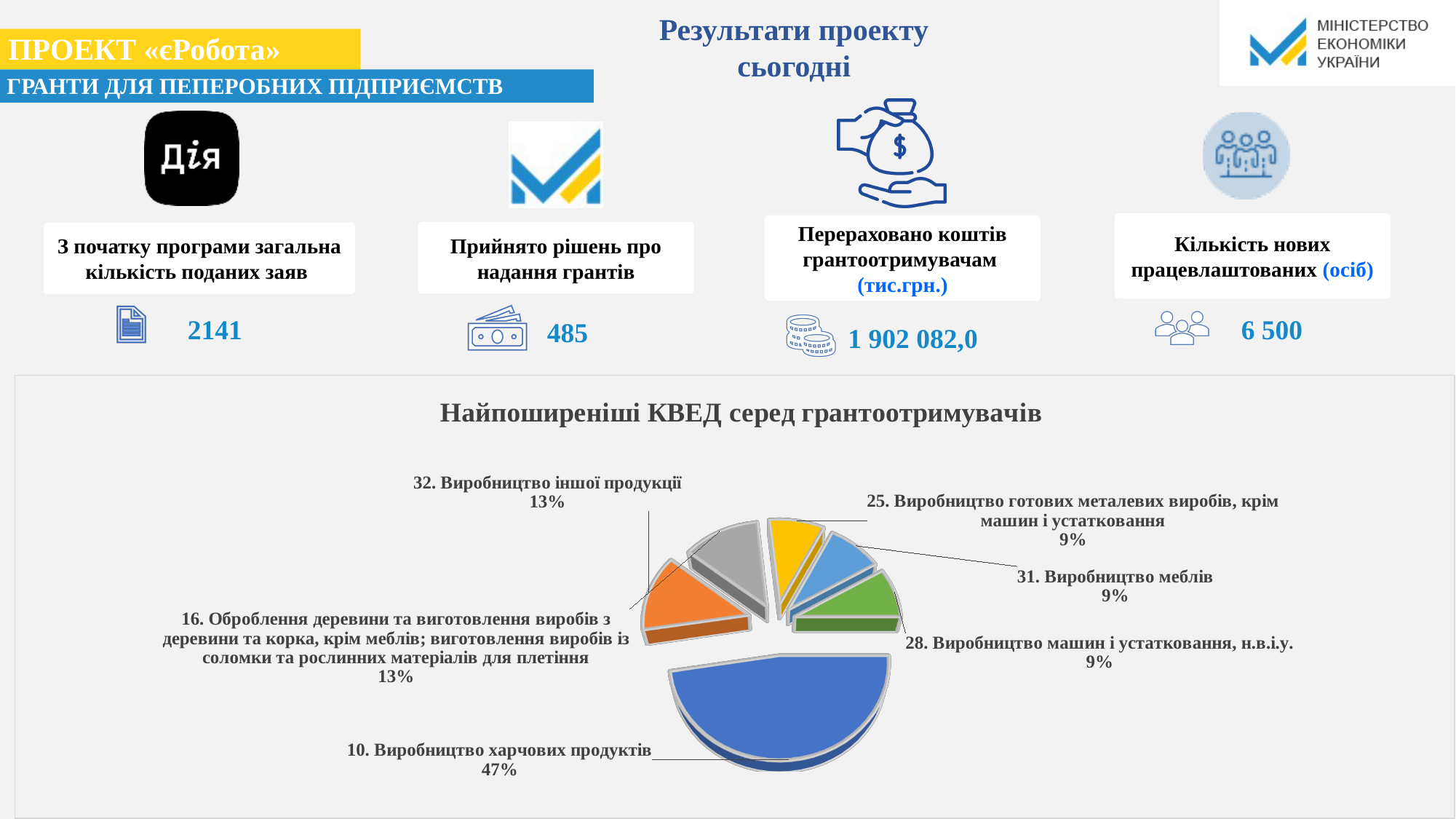
Which has a larger share: "16. Оброблення деревини..." or "25. Виробництво готових металевих виробів..."? 16. Оброблення деревини... What percentage is shown for "32. Виробництво іншої продукції"? 13% Which category has the largest share in the pie chart? 10. Виробництво харчових продуктів What percentage is shown for "28. Виробництво машин і устатковання, н.в.і.у."? 9% What colour is the slice for "10. Виробництво харчових продуктів"? blue How many categories in the pie chart have a share of 9%? 3 What is the title of the pie chart? Найпоширеніші КВЕД серед грантоотримувачів What kind of chart is shown under the title "Найпоширеніші КВЕД серед грантоотримувачів"? pie chart What percentage is shown for "31. Виробництво меблів"? 9% How many slices does the pie chart have? 6 What share of the pie does "10. Виробництво харчових продуктів" have? 47% What is the difference in percentage points between "10. Виробництво харчових продуктів" and "32. Виробництво іншої продукції"? 34